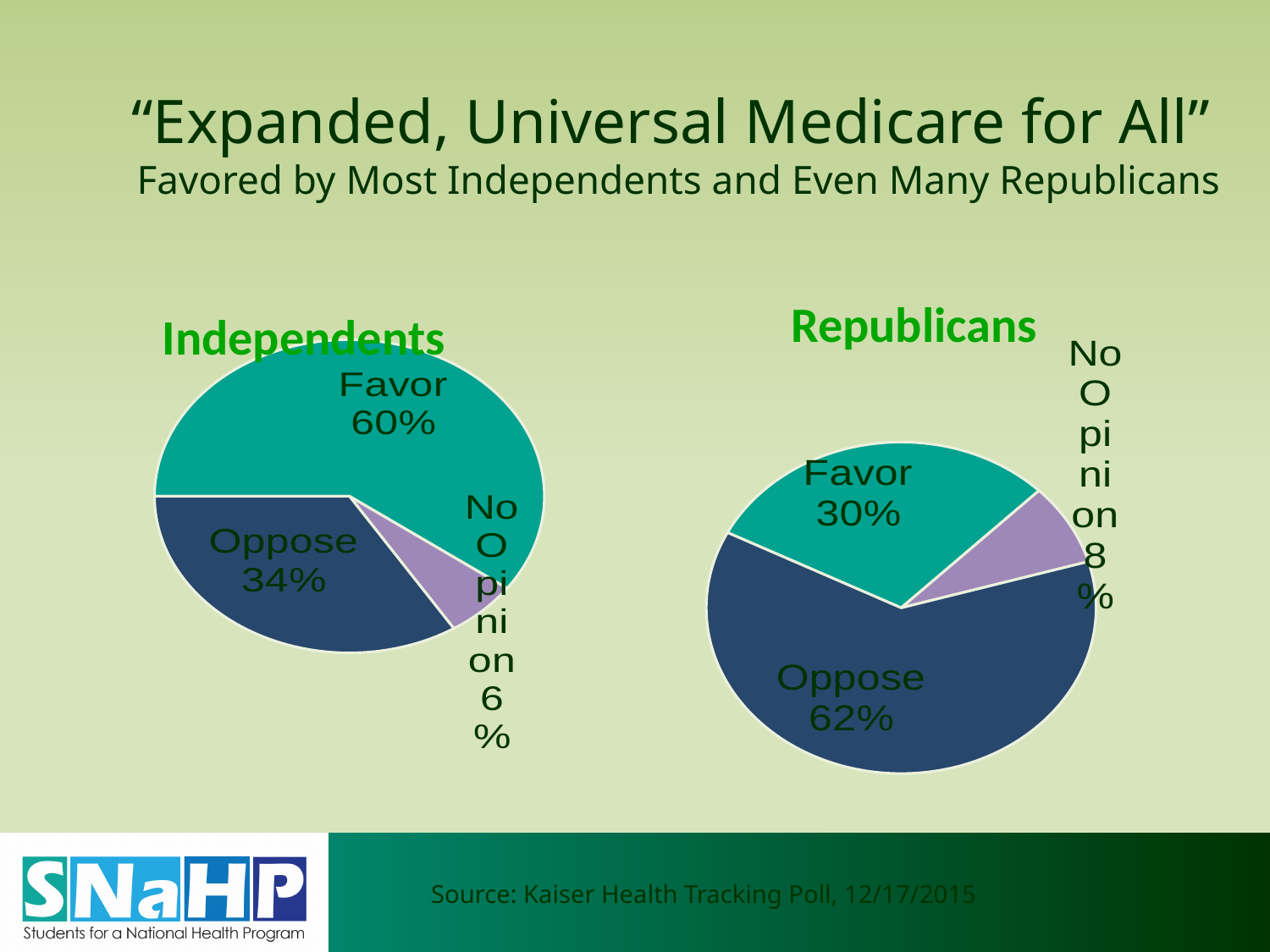
How many slices does the Independents chart have? 3 In the Independents chart, what percentage have no opinion? 6% In the Republicans chart, what percentage favor? 30% In the Republicans chart, what percentage have no opinion? 8% Which is larger: the Favor share among Independents or the Favor share among Republicans? Independents In the Republicans chart, which response has the smallest share? No Opinion In the Republicans chart, what percentage oppose? 62% What type of chart is the Republicans chart? Pie chart In the Independents chart, which response has the largest share? Favor In the Independents chart, what percentage oppose? 34% In the Republicans chart, what is the difference between the Oppose and Favor shares? 32% In the Independents chart, what percentage favor expanded, universal Medicare for All? 60%